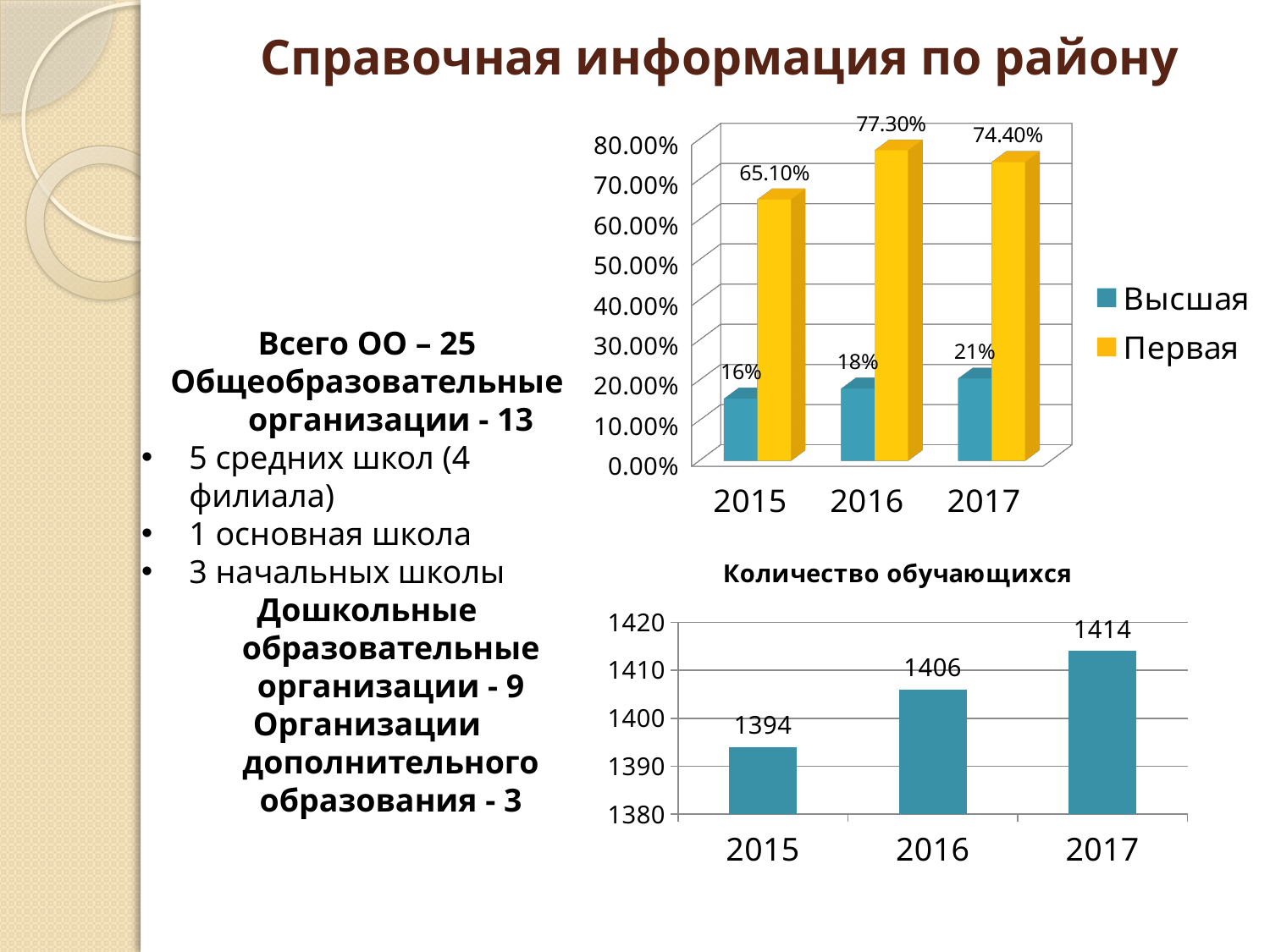
In the top chart, which is larger: Первая in 2017 or Первая in 2015? Первая in 2017 In the chart titled Количество обучающихся, what is the difference between the values for 2017 and 2015? 20 In the top chart, what is the value for Высшая in 2017? 21% In the top chart, which year has the lowest value for Высшая? 2015 What kind of chart is the chart titled Количество обучающихся? bar chart In the top chart, how many series does the legend list? 2 In the top chart, what is the difference between the Первая values for 2016 and 2015? 12.20% In the chart titled Количество обучающихся, what is the value for 2016? 1406 In the top chart, what is the value for Первая in 2016? 77.30% In the chart titled Количество обучающихся, how many years are shown on the x axis? 3 In the top chart, does the value for Высшая rise or fall from 2015 to 2017? rise In the top chart, which year has the highest value for Первая? 2016